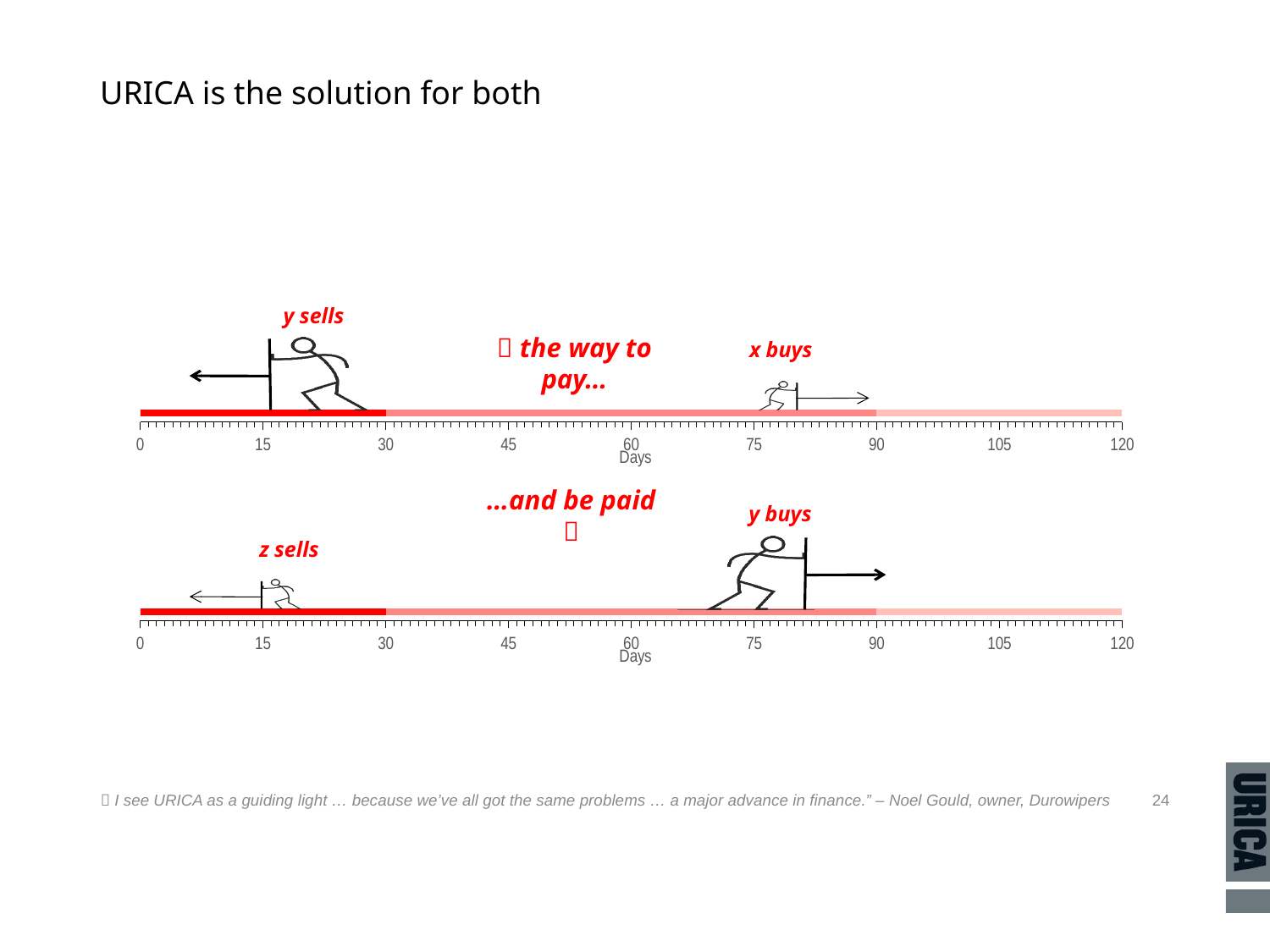
On the bottom chart, at what day value does the lightest red segment end? 120 On the top chart, at what day value does the medium red segment end? 90 What is the interval between labelled ticks on the horizontal axis of the bottom chart? 15 How many coloured segments make up the bar in the top chart? 3 What is the axis title shown beneath each timeline chart? Days What is the maximum value shown on the horizontal axis of the top chart? 120 On the top chart, how many days long is the medium red segment, which runs from 30 to 90? 60 On the bottom chart, which segment is longer: the darkest red segment (0 to 30) or the medium red segment (30 to 90)? the medium red segment What kind of chart is used for each timeline on the slide? bar chart How many timeline charts are shown on the slide? 2 On the top chart, at what day value does the darkest red segment end? 30 On the bottom chart, at what day value does the darkest red segment end? 30